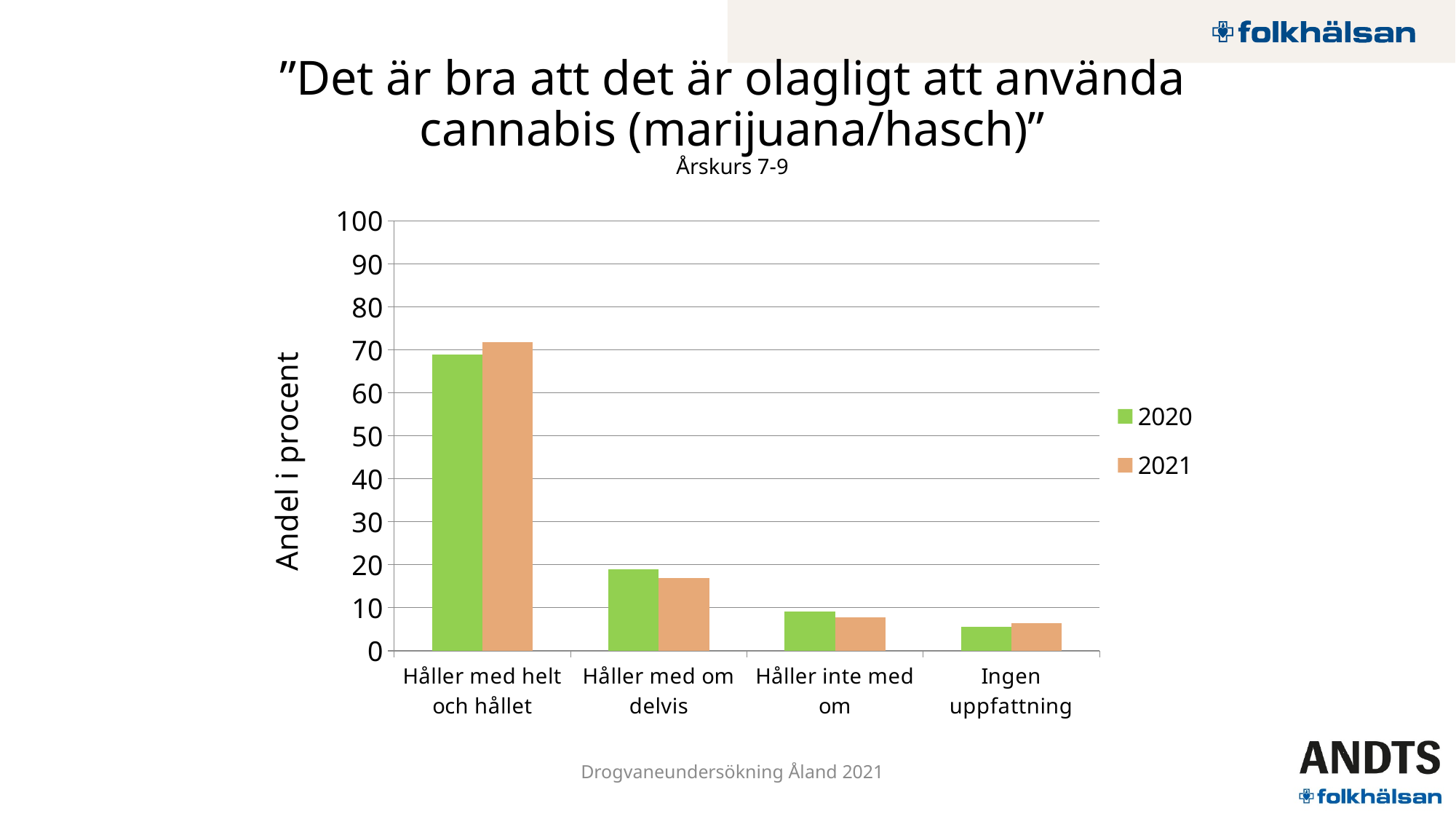
Which category has the lowest value for 2020? Ingen uppfattning For 'Håller med helt och hållet', which series has the larger value, 2020 or 2021? 2021 Is the 2020 value for 'Håller med om delvis' greater or less than 30? less How many categories are shown on the x axis? 4 For 'Håller med om delvis', which series has the larger value, 2020 or 2021? 2020 How many series does the legend list? 2 What is the title of the vertical axis? Andel i procent Which category has the lowest value for 2021? Ingen uppfattning Is the 2020 value for 'Håller med helt och hållet' greater or less than 60? greater What kind of chart is shown on the slide? Bar chart Which category has the highest value for 2020? Håller med helt och hållet Is the 2021 value for 'Håller inte med om' greater or less than 10? less